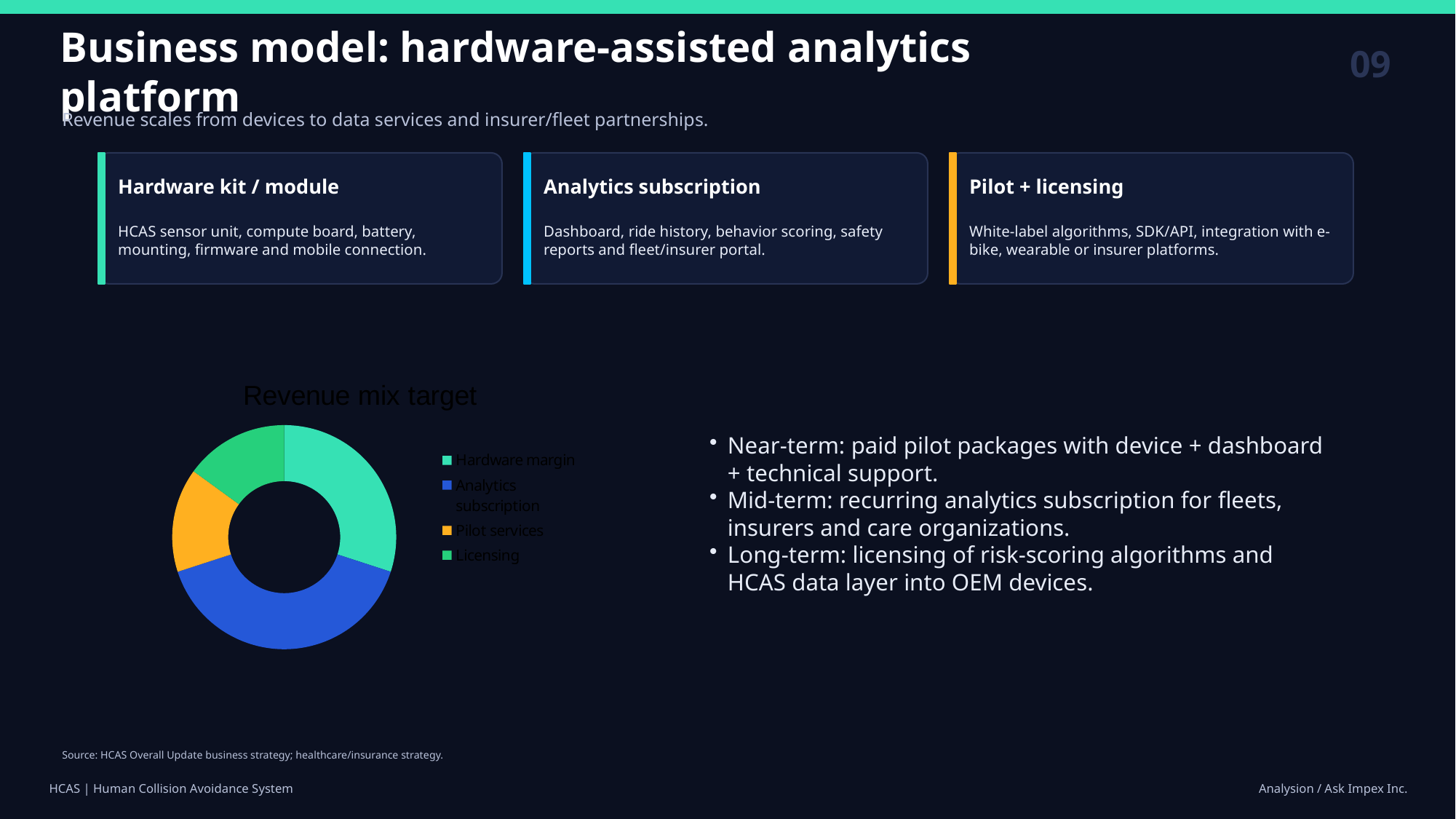
What kind of chart is the "Revenue mix target" chart? doughnut chart How many entries does the legend of the "Revenue mix target" chart list? 4 In the "Revenue mix target" chart, which is larger: Hardware margin or Licensing? Hardware margin What colour represents Pilot services in the "Revenue mix target" chart? orange In the "Revenue mix target" chart, which is larger: Hardware margin or Pilot services? Hardware margin In the "Revenue mix target" chart, which is larger: Analytics subscription or Pilot services? Analytics subscription What is the title of the chart on the slide? Revenue mix target How many categories does the "Revenue mix target" chart show? 4